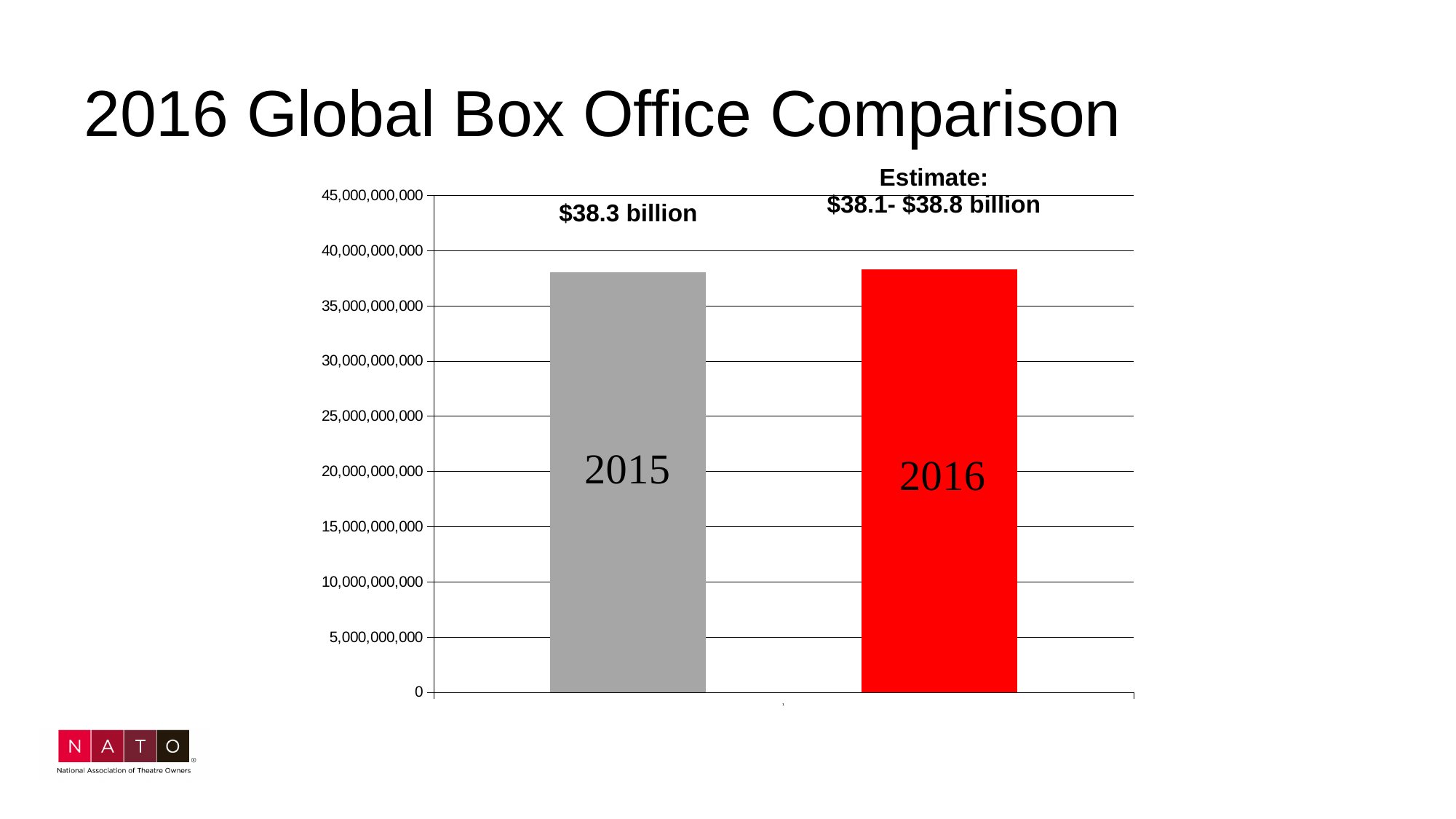
Is the value for 2016 greater or less than 35,000,000,000? greater What is the estimated global box office range shown for 2016? $38.1- $38.8 billion Is the value for 2015 greater or less than 30,000,000,000? greater What is the title of the slide containing the chart? 2016 Global Box Office Comparison What is the global box office value shown for 2015? $38.3 billion What kind of chart is shown on the slide? bar chart Is the value for 2015 greater or less than 40,000,000,000? less How many bars are plotted in the chart? 2 Which year's bar is labeled as an estimate? 2016 What colour is the bar for 2016? red